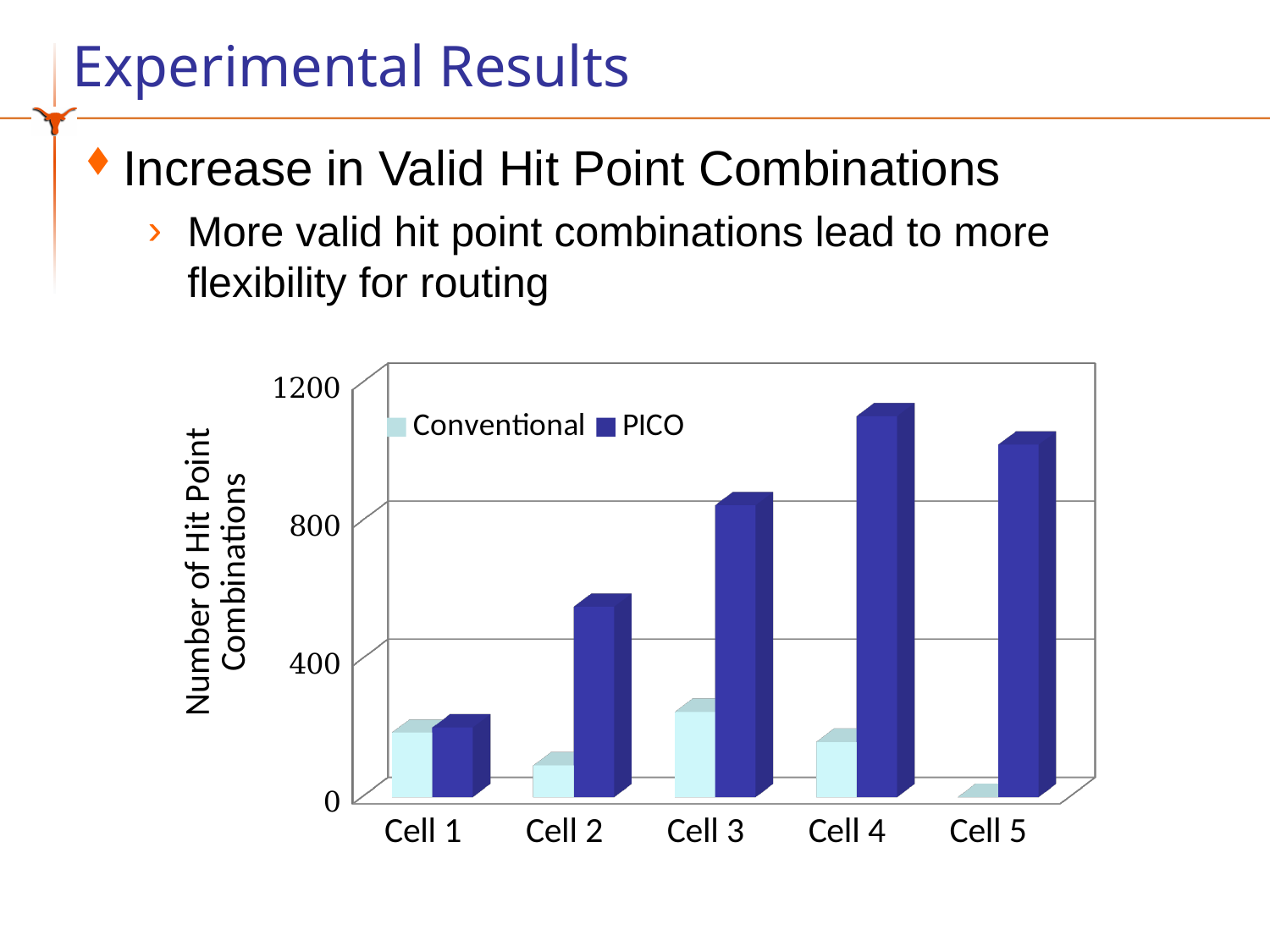
Is the PICO value for Cell 2 greater or less than 800? less Is the Conventional value for Cell 3 greater or less than 400? less How many series does the legend list? 2 What kind of chart is shown on the slide? bar chart Which cell has the highest PICO value? Cell 4 How many cells (categories) are shown on the x axis? 5 Is the PICO value for Cell 5 greater or less than 800? greater Which cell has the lowest Conventional value? Cell 5 For Cell 3, which series has the larger value, Conventional or PICO? PICO Which cell has the lowest PICO value? Cell 1 What is the label on the vertical axis of the chart? Number of Hit Point Combinations